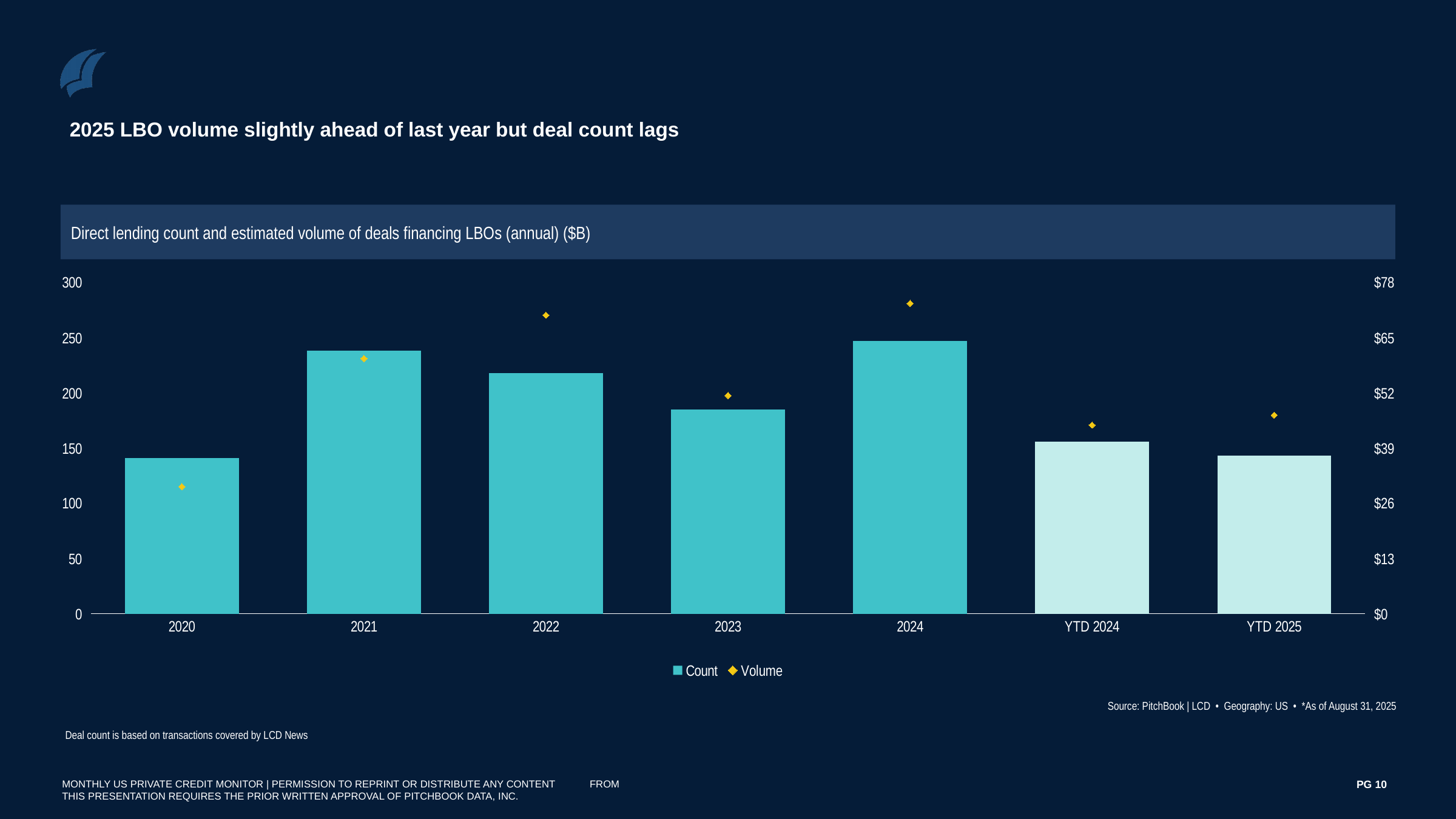
Which category has the lowest Volume marker? 2020 Is the Count value for 2022 greater or less than 200? greater Which has the larger Count, 2021 or 2022? 2021 What kind of chart is shown on the slide? bar chart (with diamond markers for volume) How many series does the legend list? 2 Which category has the highest Volume marker? 2024 Does the Count rise or fall from 2020 to 2021? rise How many categories are shown on the x axis? 7 Is the Count value for 2023 greater or less than 200? less Which category has the highest Count bar? 2024 Is the Volume value for YTD 2025 greater or less than $39? greater